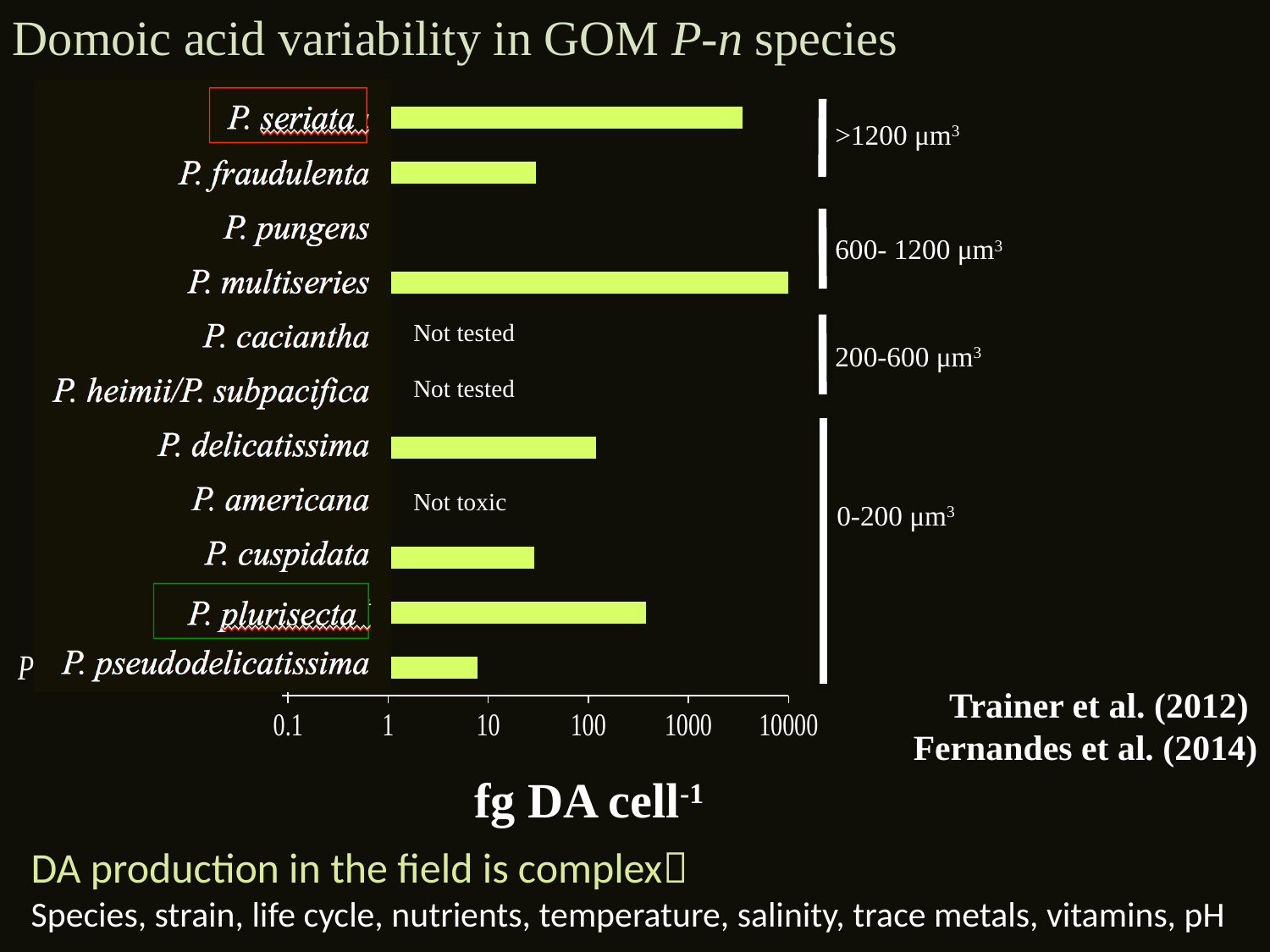
Is the value for P. plurisecta greater or less than 100 fg DA cell-1? greater Is the value for P. seriata greater or less than 1000 fg DA cell-1? greater Which species has the longest bar in the chart? P. multiseries Is the value for P. multiseries greater or less than 1000 fg DA cell-1? greater What is the label of the x axis of the chart? fg DA cell-1 What label is shown in place of a bar for P. americana? Not toxic Among the species with a plotted bar, which has the shortest bar? P. pseudodelicatissima Which has the larger value, P. seriata or P. fraudulenta? P. seriata Which has the larger value, P. plurisecta or P. cuspidata? P. plurisecta What kind of chart is shown on the slide? bar chart How many species are listed on the y axis of the chart? 11